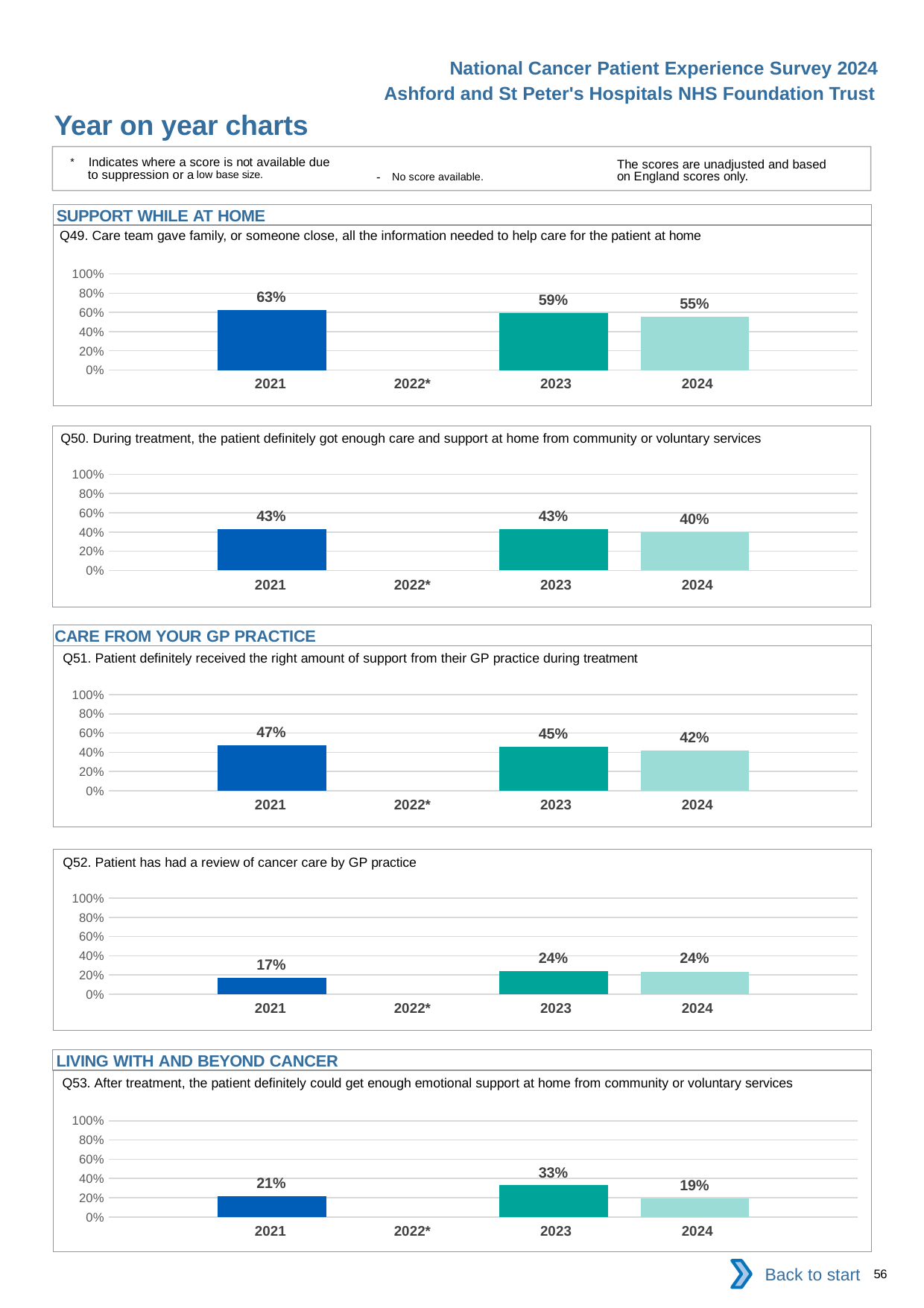
What kind of chart is used for Q53? Bar chart In the Q51 chart, what is the value for 2023? 45% In the Q53 chart, which year has the highest value? 2023 In the Q52 chart, which year has the lowest value? 2021 In the Q49 chart, what is the value for 2024? 55% In the Q53 chart, what is the value for 2024? 19% In the Q52 chart, what is the difference between the 2023 and 2021 values? 7% In the Q49 chart, which year has the highest value? 2021 In the Q50 chart, what is the value for 2023? 43% In the Q51 chart, which is larger, the value for 2021 or the value for 2024? 2021 In the Q49 chart, which year has no bar shown? 2022* In the Q50 chart, what is the difference between the 2021 and 2024 values? 3%